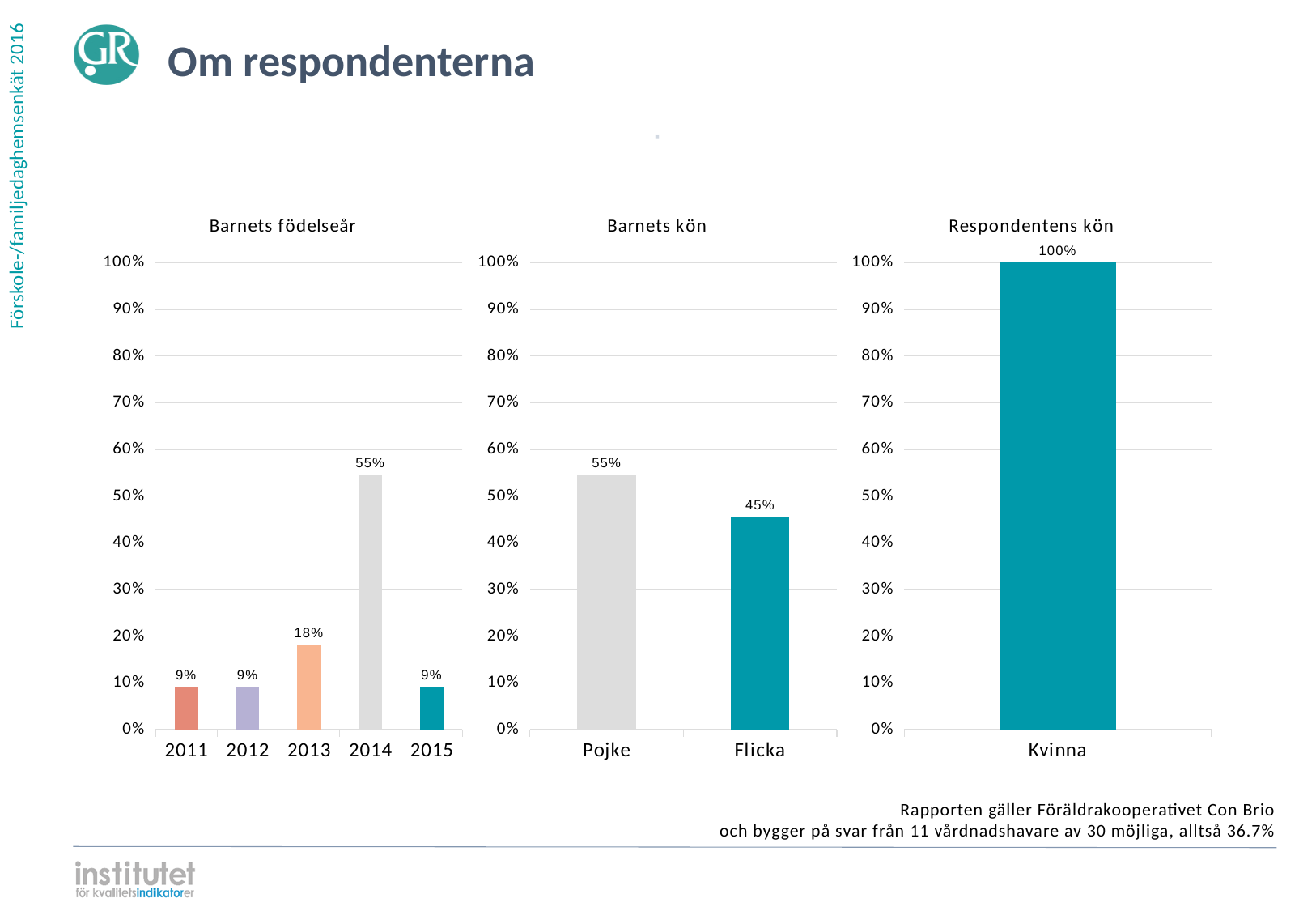
In the 'Barnets kön' chart, what is the difference between Pojke and Flicka? 10% In the 'Barnets födelseår' chart, which birth year has the highest value? 2014 In the 'Barnets födelseår' chart, is the value for 2014 greater or less than 50%? greater In the 'Barnets födelseår' chart, how many birth-year categories are shown? 5 In the 'Barnets kön' chart, what is the value for Flicka? 45% In the 'Respondentens kön' chart, what is the value for Kvinna? 100% In the 'Barnets kön' chart, which is larger, Pojke or Flicka? Pojke In the 'Barnets födelseår' chart, what is the value for 2014? 55% In the 'Barnets födelseår' chart, what is the value for 2013? 18% What is the title of the rightmost chart on the slide? Respondentens kön In the 'Barnets födelseår' chart, what is the difference between the values for 2014 and 2013? 37% What kind of chart is the 'Barnets kön' chart? Bar chart